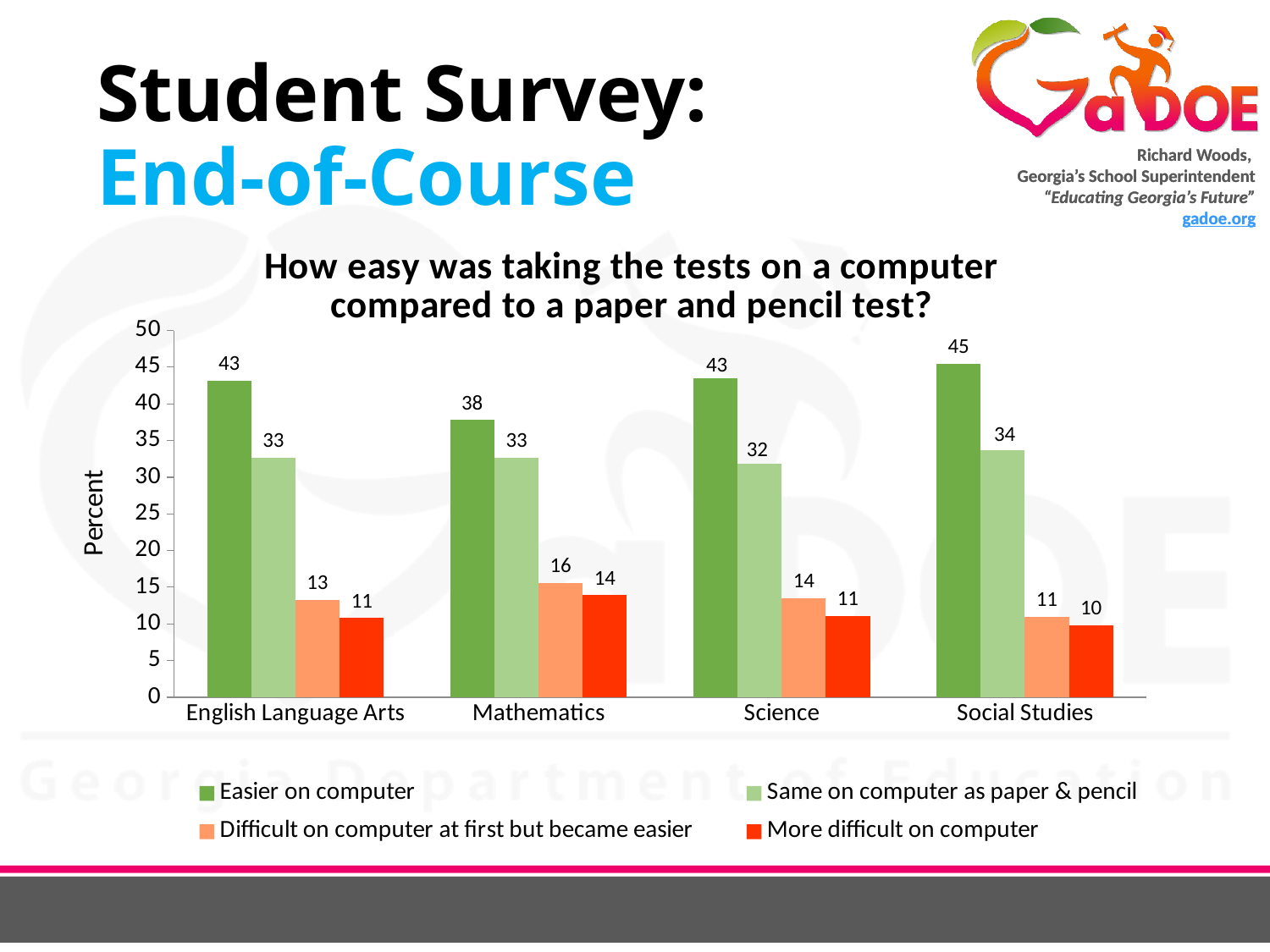
What is the difference between the 'Easier on computer' and 'Same on computer as paper & pencil' percents for Social Studies? 11 Which is larger for Mathematics: 'Difficult on computer at first but became easier' or 'More difficult on computer'? Difficult on computer at first but became easier What percent of students said the test was easier on computer for Mathematics? 38 How many series does the legend list? 4 What kind of chart is shown on the slide? Bar chart What percent of students said the test was more difficult on computer for Social Studies? 10 What is the label of the y axis? Percent What percent of students said the test was the same on computer as paper & pencil for Science? 32 How many subjects are shown on the x axis? 4 Which subject has the highest percent for 'Easier on computer'? Social Studies What colour represents 'More difficult on computer' in the legend? Red Which subject has the lowest percent for 'Easier on computer'? Mathematics